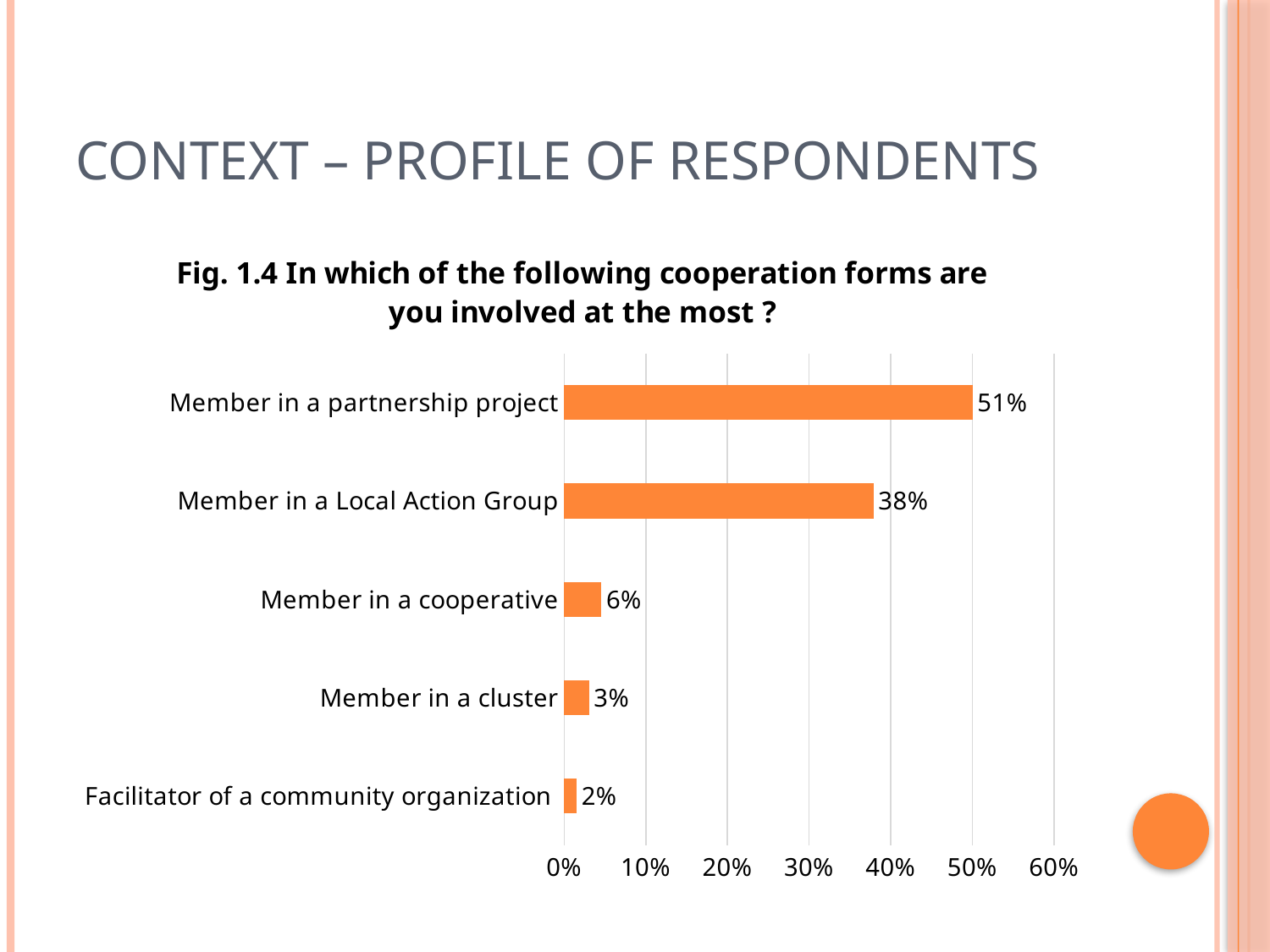
Which cooperation form has the lowest percentage of respondents? Facilitator of a community organization What percentage of respondents are a member in a cooperative? 6% What percentage of respondents are a facilitator of a community organization? 2% What is the figure number given in the chart title? Fig. 1.4 Is the value for 'Member in a Local Action Group' greater or less than 40%? less What is the difference in percentage points between 'Member in a partnership project' and 'Member in a Local Action Group'? 13 percentage points Which cooperation form has the highest percentage of respondents? Member in a partnership project What percentage of respondents are a member in a partnership project? 51% What percentage of respondents are a member in a Local Action Group? 38% Which is larger: the value for 'Member in a cooperative' or 'Member in a cluster'? Member in a cooperative How many cooperation forms are shown in the chart? 5 What type of chart is shown on the slide? Bar chart